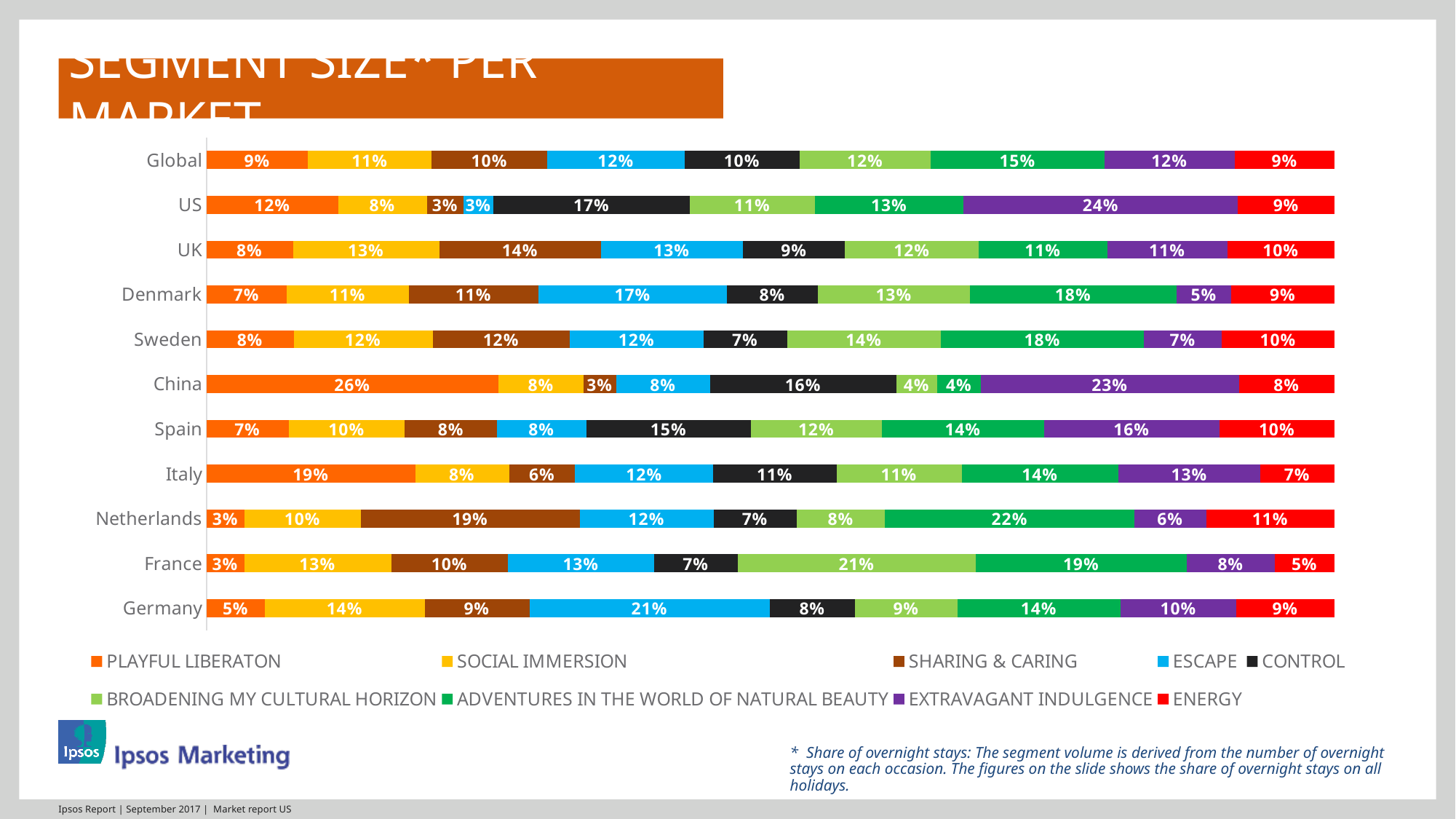
What is the Escape value for Germany? 21% Which market has the highest Playful Liberaton value? China What kind of chart is shown on the slide? Stacked bar chart What is the Control value for China? 16% What is the Extravagant Indulgence value for the US? 24% How many series does the legend list? 9 Which is larger, the Broadening My Cultural Horizon value for France or for Spain? France What is the difference between the Adventures in the World of Natural Beauty values for the Netherlands and Global? 7% What is the total of the Global bar? 100% Which colour represents the Control series in the legend? Black How many markets are shown on the chart? 11 Which market has the lowest Energy value? France